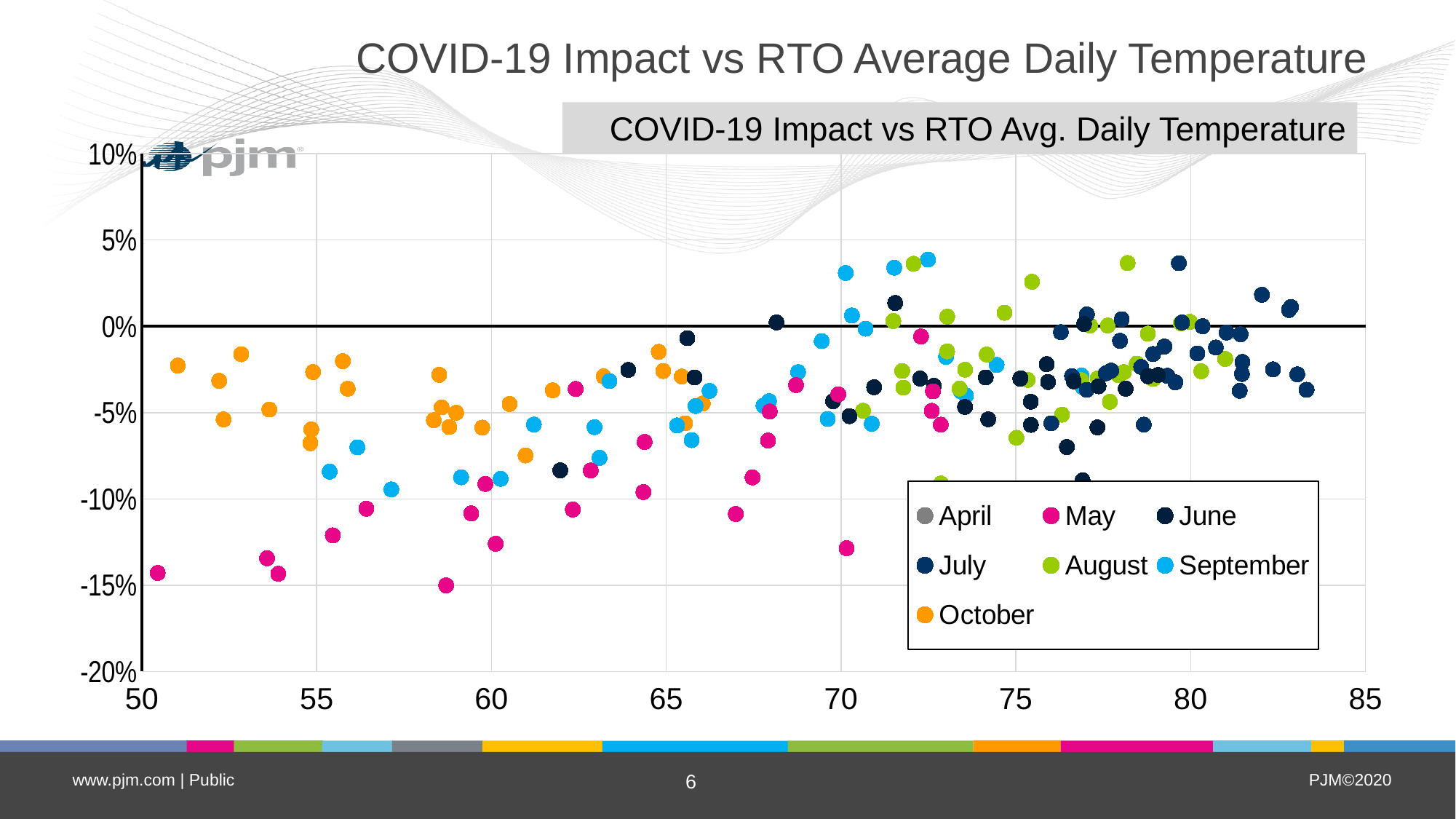
What kind of chart is shown on the slide? Scatter chart Is the lowest May point greater or less than -10%? less Which series contains the lowest plotted point on the chart? May What is the title of the chart? COVID-19 Impact vs RTO Avg. Daily Temperature What is the range of the y axis? -20% to 10% What is the range of the x axis? 50 to 85 As the average daily temperature increases along the x axis, do the COVID-19 impact values generally rise or fall? Rise How many series does the legend list? 7